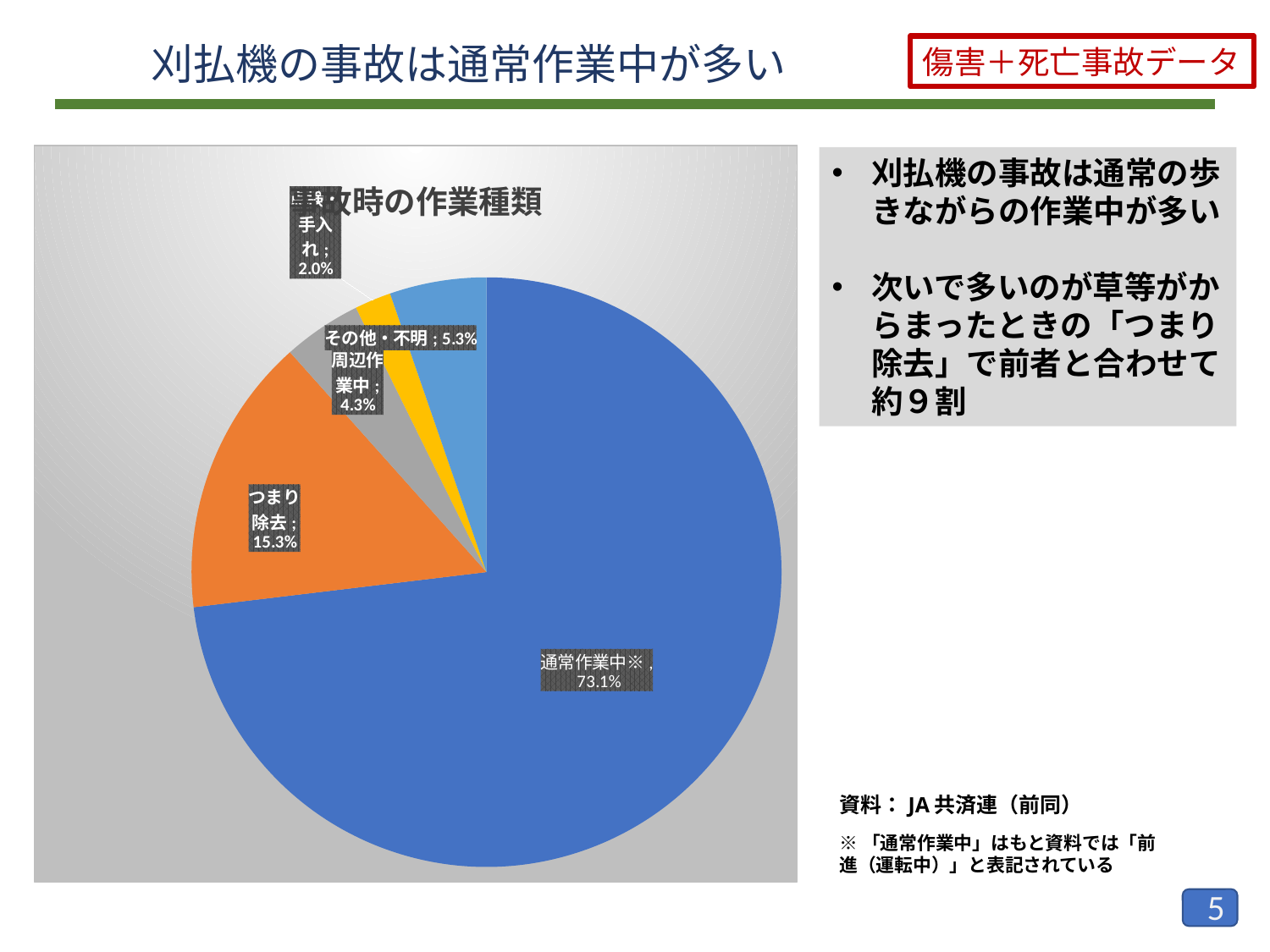
What share of the pie does 通常作業中※ account for? 73.1% What is the combined share of 通常作業中※ and つまり除去? 88.4% Which category has the smallest slice of the pie? 手入れ What percentage is shown for つまり除去? 15.3% How many slices does the pie chart have? 5 What percentage is shown for その他・不明? 5.3% What percentage is shown for 手入れ? 2.0% How many percentage points larger is 通常作業中※ than つまり除去? 57.8 percentage points What percentage is shown for 周辺作業中? 4.3% Which category has the largest slice of the pie? 通常作業中※ What kind of chart is shown on the slide? Pie chart Which is larger, その他・不明 or 周辺作業中? その他・不明